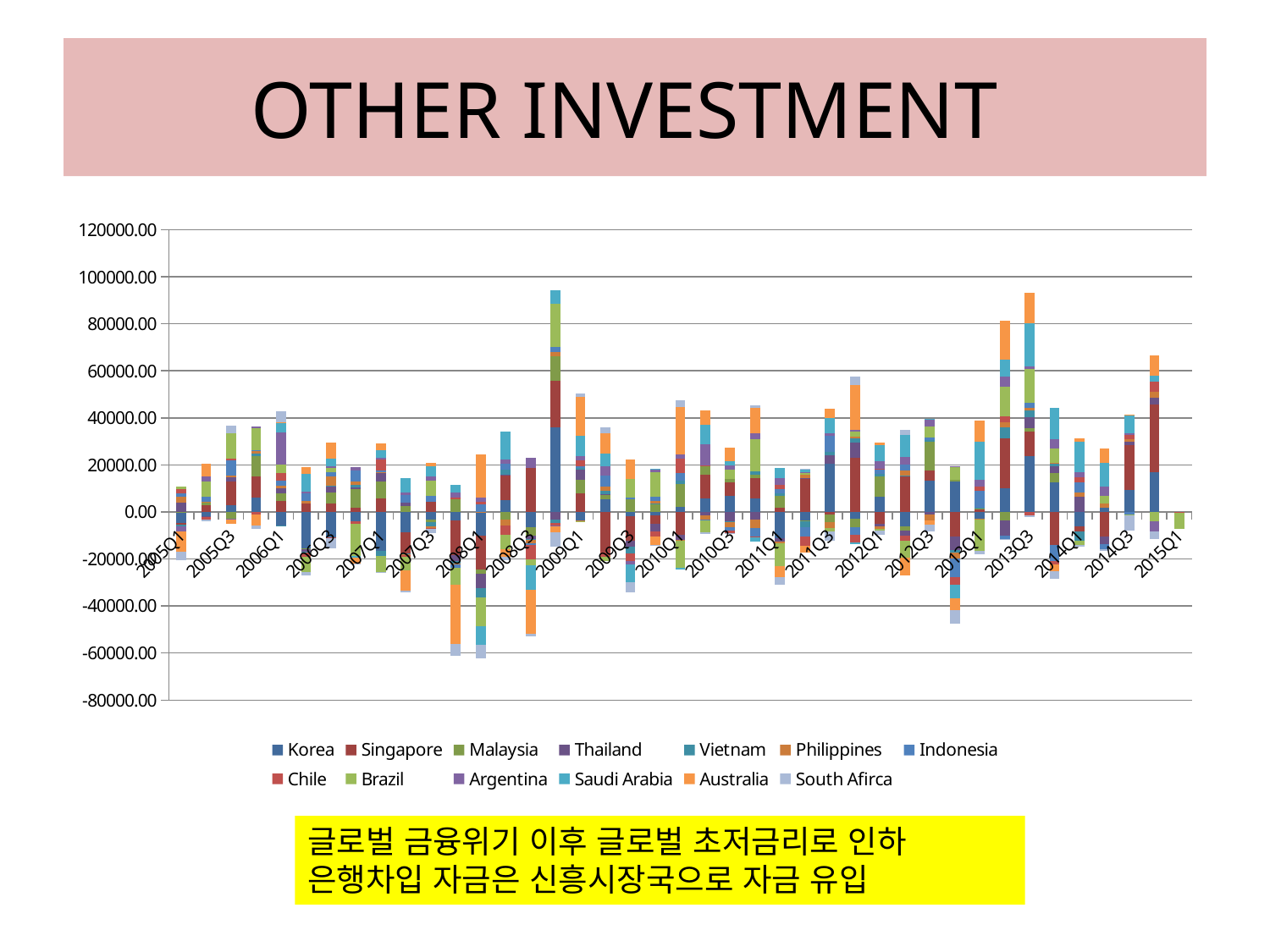
What is the title of the chart? OTHER INVESTMENT Is the bottom of the negative stacked bar for 2008Q1 greater or less than -40000.00? less Which series is listed first in the legend? Korea How many series does the legend list? 13 Is the top of the positive stacked bar for 2013Q3 greater or less than 80000.00? greater Is the bottom of the negative stacked bar for 2013Q1 greater or less than -40000.00? greater Which quarter's negative stacked bar extends further below zero, 2008Q1 or 2010Q1? 2008Q1 Which quarter has the taller positive stacked bar, 2009Q1 or 2005Q1? 2009Q1 What kind of chart is shown on the slide? Stacked bar chart